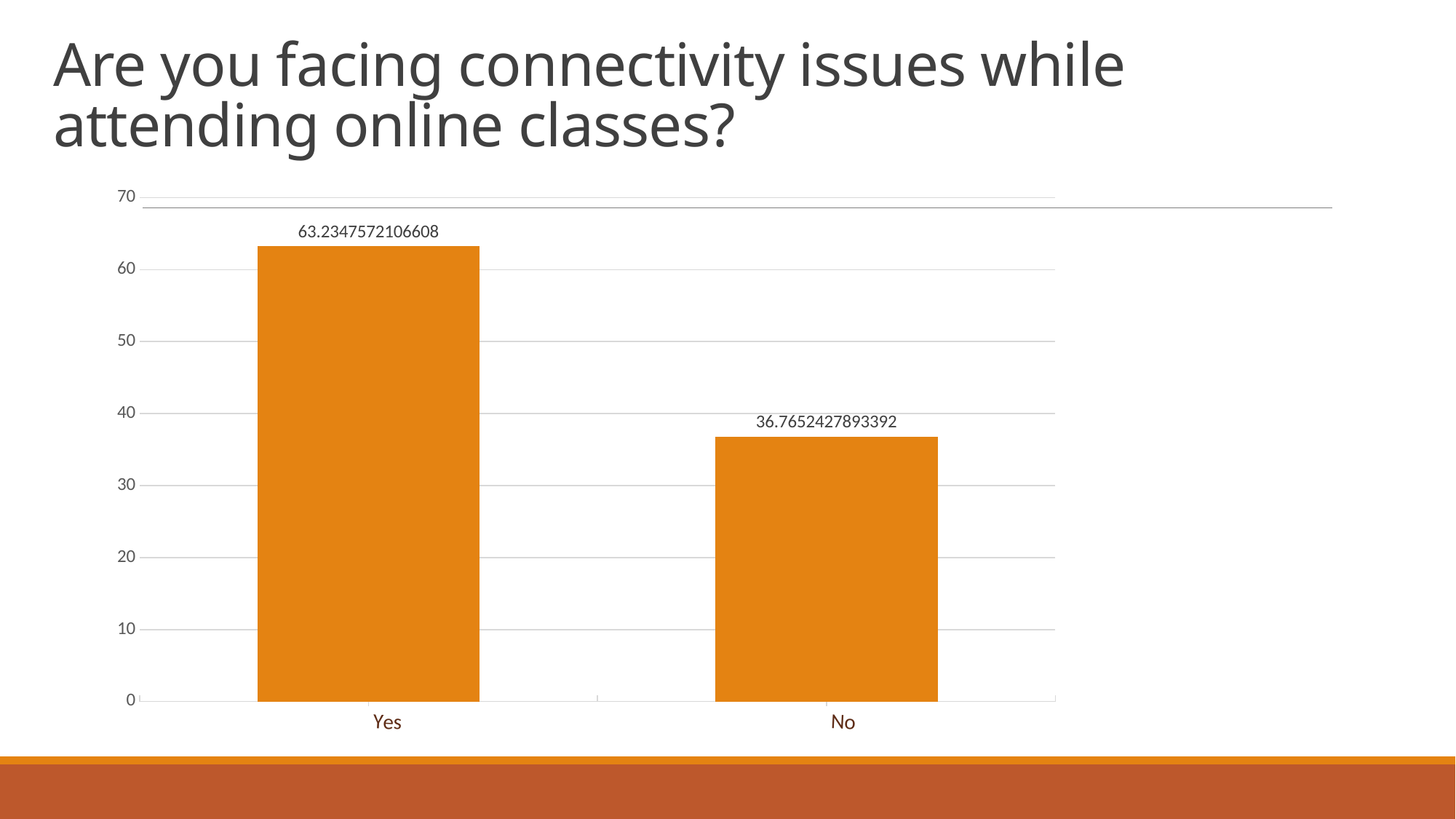
Is the value for No greater or less than 40? less What is the highest value shown on the vertical axis? 70 What is the value for Yes? 63.2347572106608 How many categories are shown on the x axis? 2 What is the difference between the values for Yes and No? 26.4695144213216 Is the value for Yes greater or less than 60? greater What kind of chart is shown on the slide? bar chart Which category has the highest value? Yes What is the sum of the values for Yes and No? 100 Which is larger, the value for Yes or the value for No? Yes What is the value for No? 36.7652427893392 Which category has the lowest value? No